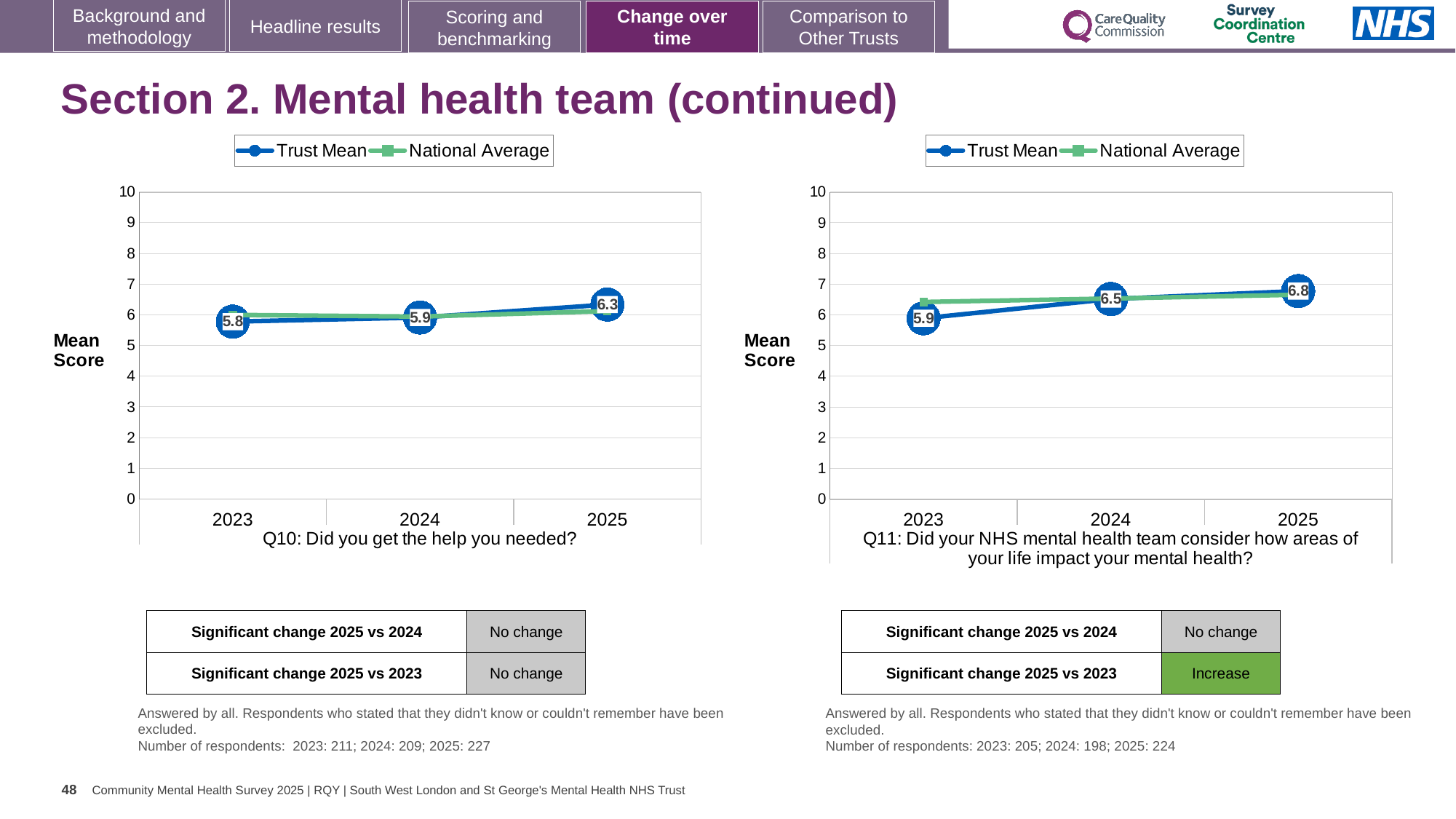
In the Q11 chart (right), what is the Trust Mean for 2025? 6.8 In the Q11 chart (right), what is the difference between the Trust Mean for 2025 and 2023? 0.9 Which is larger: the 2025 Trust Mean in the Q10 chart (left) or the 2025 Trust Mean in the Q11 chart (right)? Q11 chart (right) In the Q10 chart (left), what is the Trust Mean for 2023? 5.8 In the Q10 chart (left), which year has the lowest Trust Mean? 2023 How many series does the legend of the Q11 chart (right) list? 2 In the Q11 chart (right), which year has the highest Trust Mean? 2025 In the Q10 chart (left), what is the Trust Mean for 2025? 6.3 In the Q10 chart (left), does the Trust Mean rise or fall from 2023 to 2025? rise In the Q10 chart (left), what is the difference between the Trust Mean for 2025 and 2024? 0.4 In the Q11 chart (right), what is the Trust Mean for 2024? 6.5 What kind of chart is the Q10 chart (left)? line chart